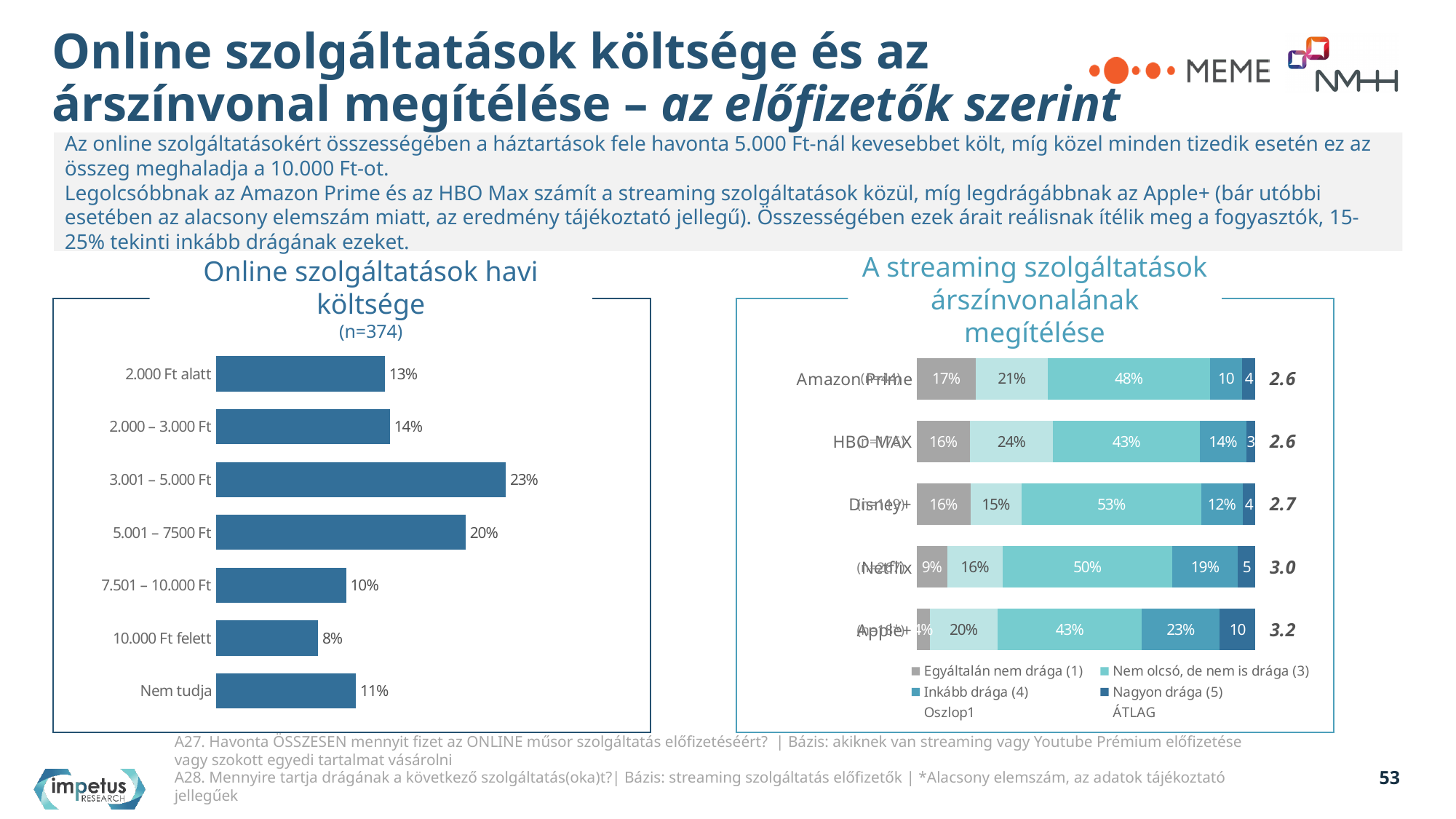
In the chart 'A streaming szolgáltatások árszínvonalának megítélése', what is the 'Nem olcsó, de nem is drága (3)' value for Netflix? 50% In the chart 'Online szolgáltatások havi költsége', what is the difference between the values for '3.001 – 5.000 Ft' and '10.000 Ft felett'? 15 percentage points How many categories are shown in the chart 'Online szolgáltatások havi költsége'? 7 In the chart 'Online szolgáltatások havi költsége', which category has the highest value? 3.001 – 5.000 Ft In the chart 'A streaming szolgáltatások árszínvonalának megítélése', what is the 'Egyáltalán nem drága (1)' value for Disney+? 16% In the chart 'Online szolgáltatások havi költsége', which is larger: the value for '2.000 Ft alatt' or for '2.000 – 3.000 Ft'? 2.000 – 3.000 Ft In the chart 'Online szolgáltatások havi költsége', which category has the lowest value? 10.000 Ft felett In the chart 'A streaming szolgáltatások árszínvonalának megítélése', what is the average (ÁTLAG) value shown for Apple+? 3.2 What kind of chart is 'Online szolgáltatások havi költsége'? Bar chart In the chart 'A streaming szolgáltatások árszínvonalának megítélése', which service has the highest average (ÁTLAG) value? Apple+ In the chart 'Online szolgáltatások havi költsége', what is the value for '3.001 – 5.000 Ft'? 23% What sample size (n) is shown under the title of the chart 'Online szolgáltatások havi költsége'? n=374